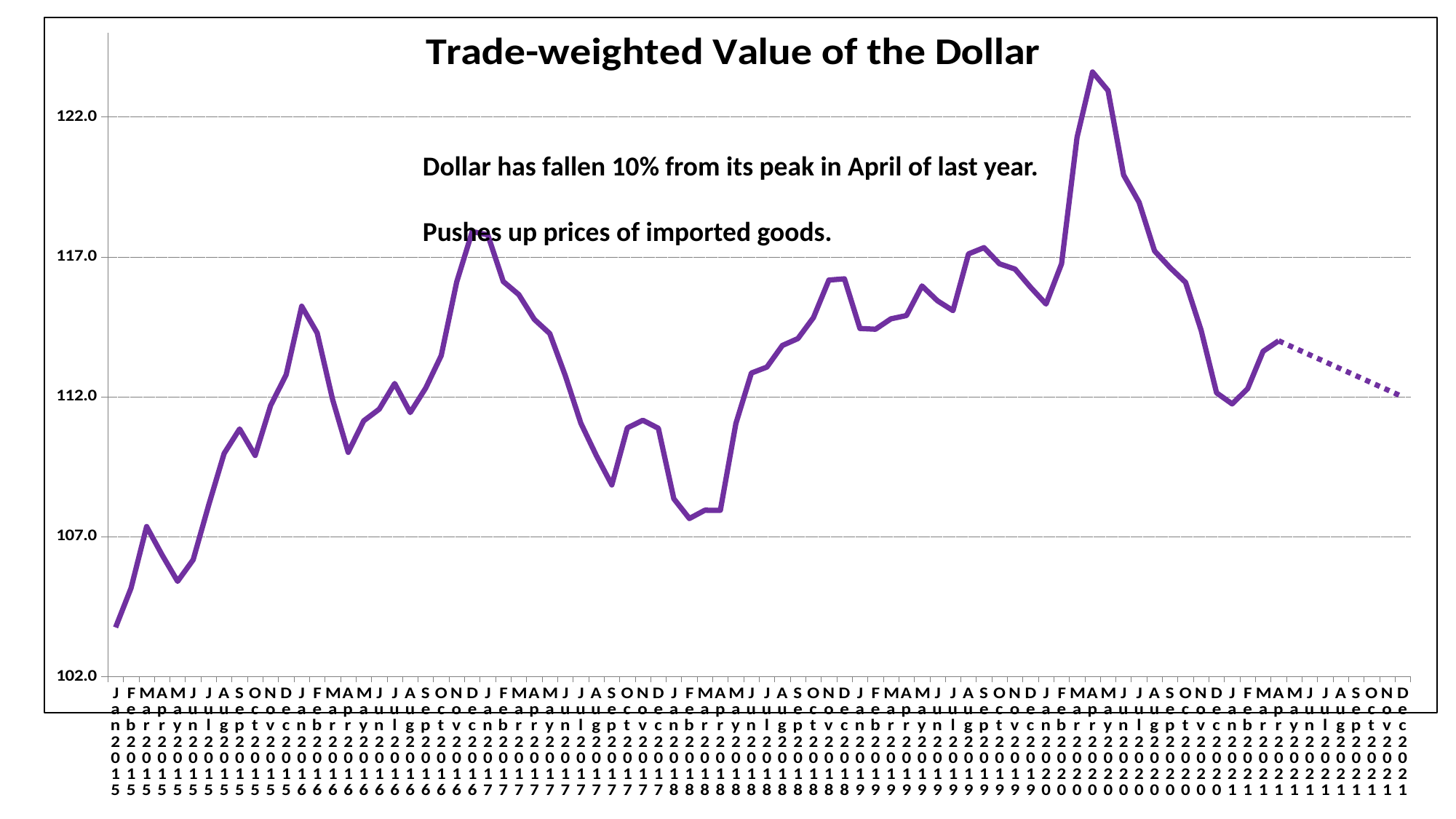
Is the value for January 2016 greater or less than 112.0? greater In which month does the trade-weighted value of the dollar reach its highest point on the chart? April 2020 Does the trade-weighted value of the dollar rise or fall from January 2015 to December 2015? rise In which month is the trade-weighted value of the dollar lowest on the chart? January 2015 Is the value for April 2020 greater or less than 122.0? greater What kind of chart is shown on the slide? line chart According to the text on the chart, by how much has the dollar fallen from its peak in April of last year? 10% What is the title of the chart? Trade-weighted Value of the Dollar Which is larger, the value for January 2015 or the value for January 2016? January 2016 Does the trade-weighted value of the dollar rise or fall from April 2020 to January 2021? fall Is the value for January 2015 greater or less than 107.0? less